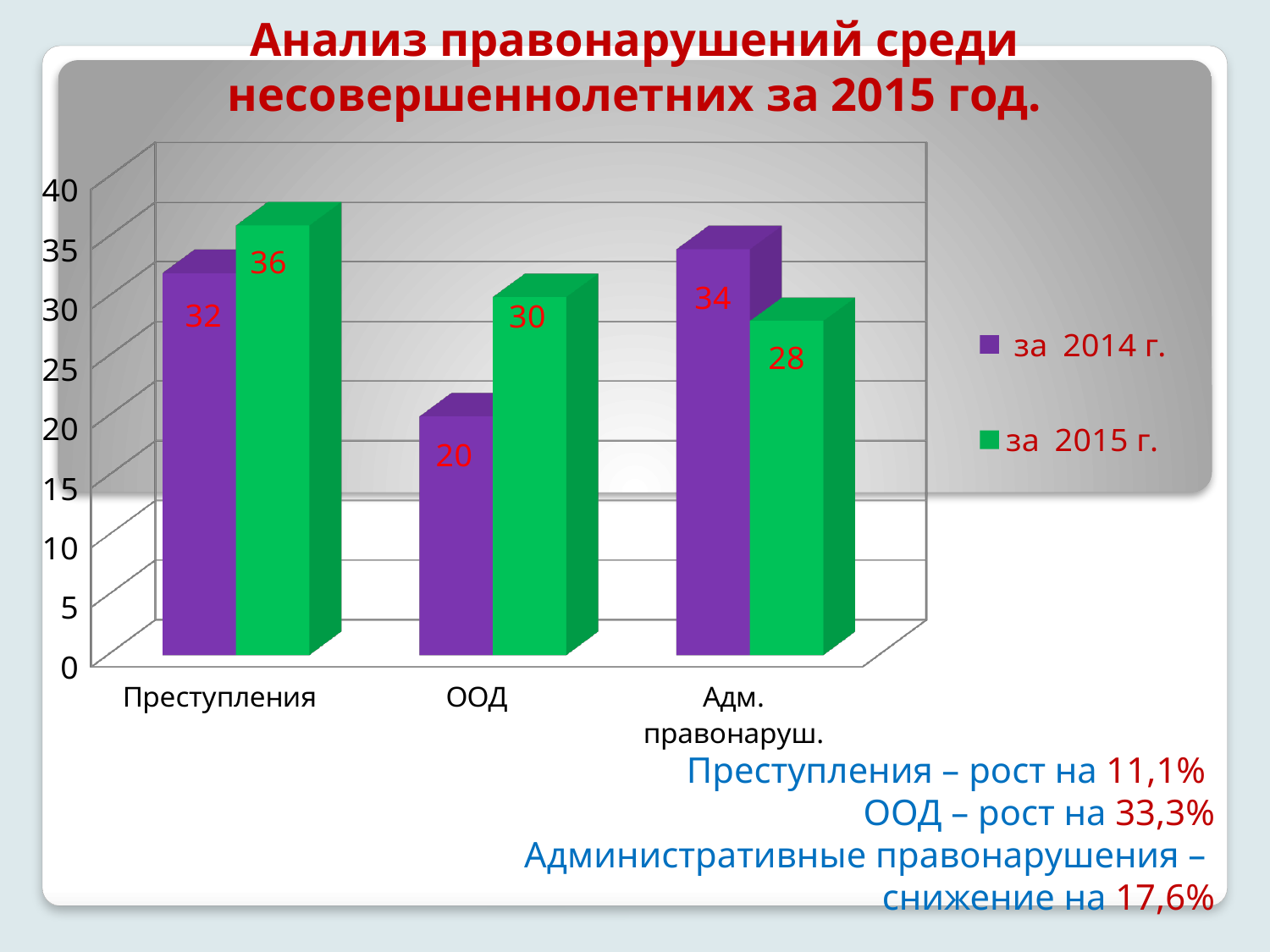
How many categories are shown on the x axis? 3 How many series does the legend list? 2 Which category has the lowest value in the series за 2014 г.? ООД What is the value for Преступления in the series за 2014 г.? 32 What is the value for ООД in the series за 2015 г.? 30 Is the value for Преступления in за 2015 г. greater or less than 35? greater What is the value for Адм. правонаруш. in the series за 2014 г.? 34 What colour represents the series за 2015 г.? green Which category has the highest value in the series за 2015 г.? Преступления What kind of chart is shown on the slide? bar chart Which is larger for Адм. правонаруш.: the за 2014 г. value or the за 2015 г. value? за 2014 г. What is the difference between the за 2015 г. and за 2014 г. values for ООД? 10